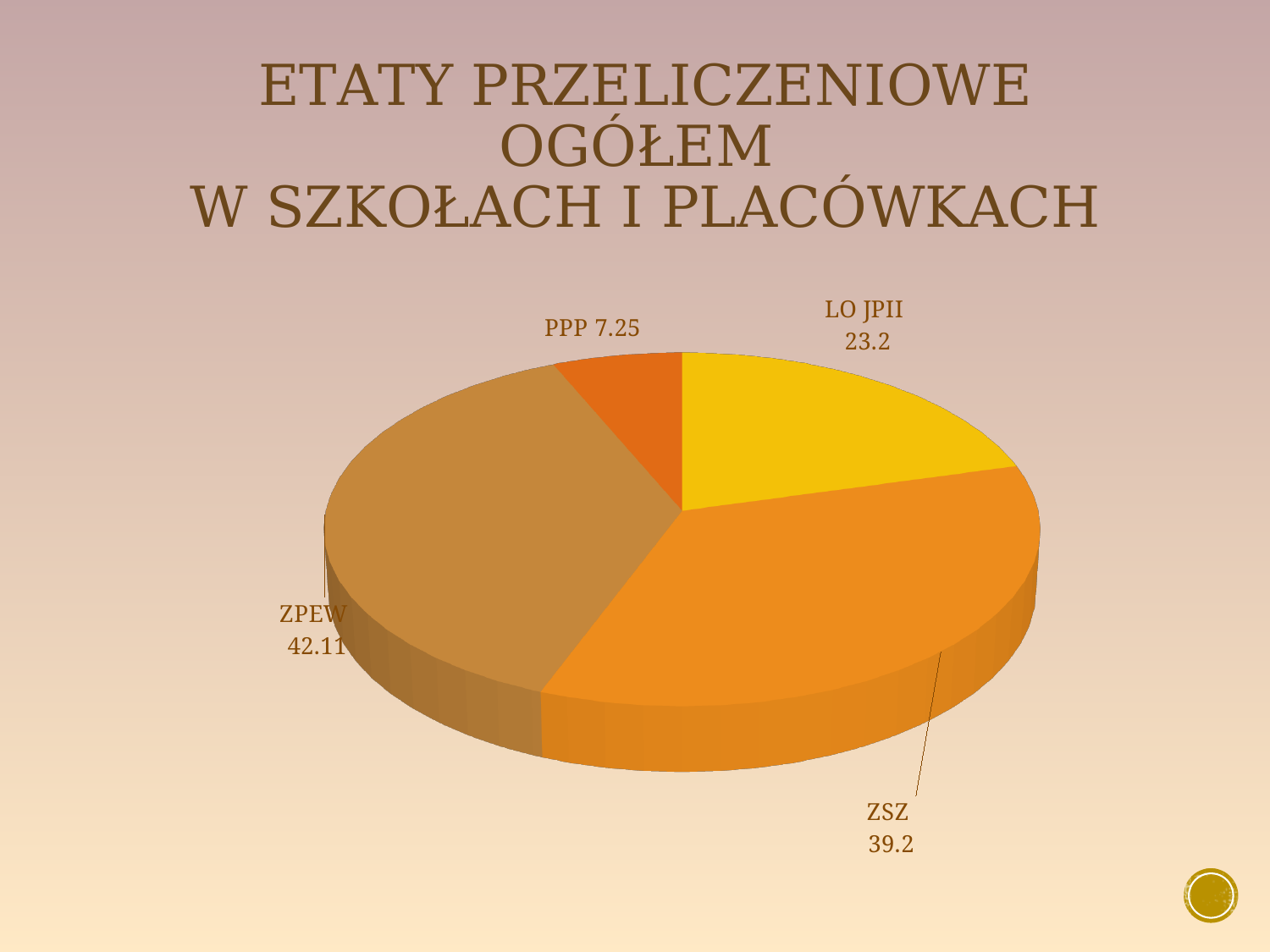
How many categories are shown in the pie chart? 4 What is the value for ZSZ? 39.2 What is the value for PPP? 7.25 What is the value for ZPEW? 42.11 Which is larger, the value for LO JPII or the value for PPP? LO JPII What is the value for LO JPII? 23.2 Which category has the largest slice of the pie? ZPEW What is the difference between the values for ZSZ and LO JPII? 16 Which category has the smallest slice of the pie? PPP What is the difference between the values for ZPEW and ZSZ? 2.91 What is the title of the chart on the slide? ETATY PRZELICZENIOWE OGÓŁEM W SZKOŁACH I PLACÓWKACH What kind of chart is shown on the slide? pie chart